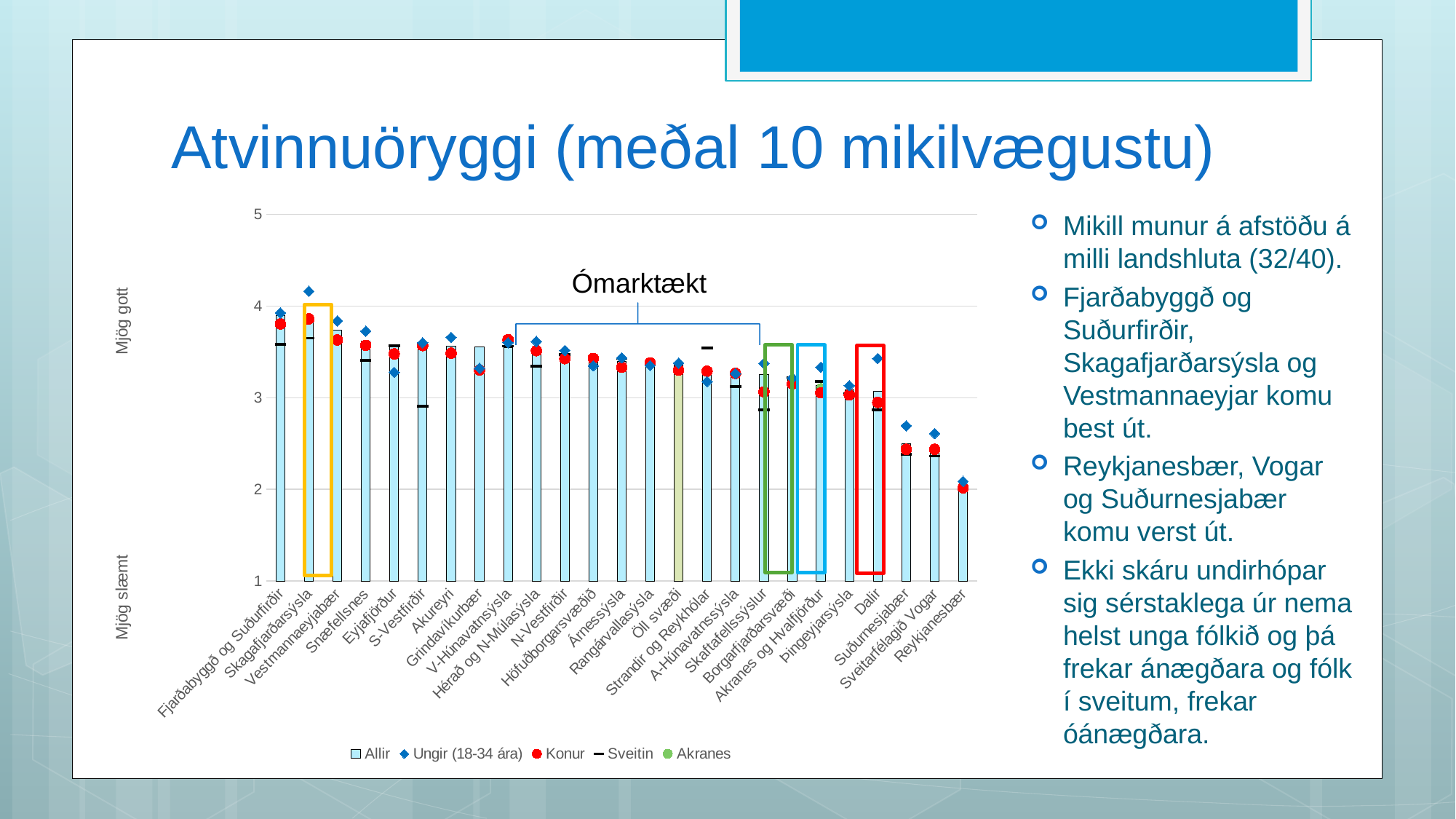
Is the 'Allir' value for Reykjanesbær greater or less than 3? less How many categories are shown along the x axis of the chart? 25 How many series does the chart legend list? 5 What kind of chart is shown on the slide? bar chart Is the 'Allir' value for Suðurnesjabær greater or less than 3? less Is the 'Allir' value for Fjarðabyggð og Suðurfirðir greater or less than 3? greater What is the title of the slide containing the chart? Atvinnuöryggi (meðal 10 mikilvægustu) Which has the larger 'Allir' value: Fjarðabyggð og Suðurfirðir or Reykjanesbær? Fjarðabyggð og Suðurfirðir Do the 'Allir' bar values generally rise or fall from left to right along the x axis? fall Which category has the lowest 'Allir' bar in the chart? Reykjanesbær Which legend entry is represented by red circle markers in the chart? Konur